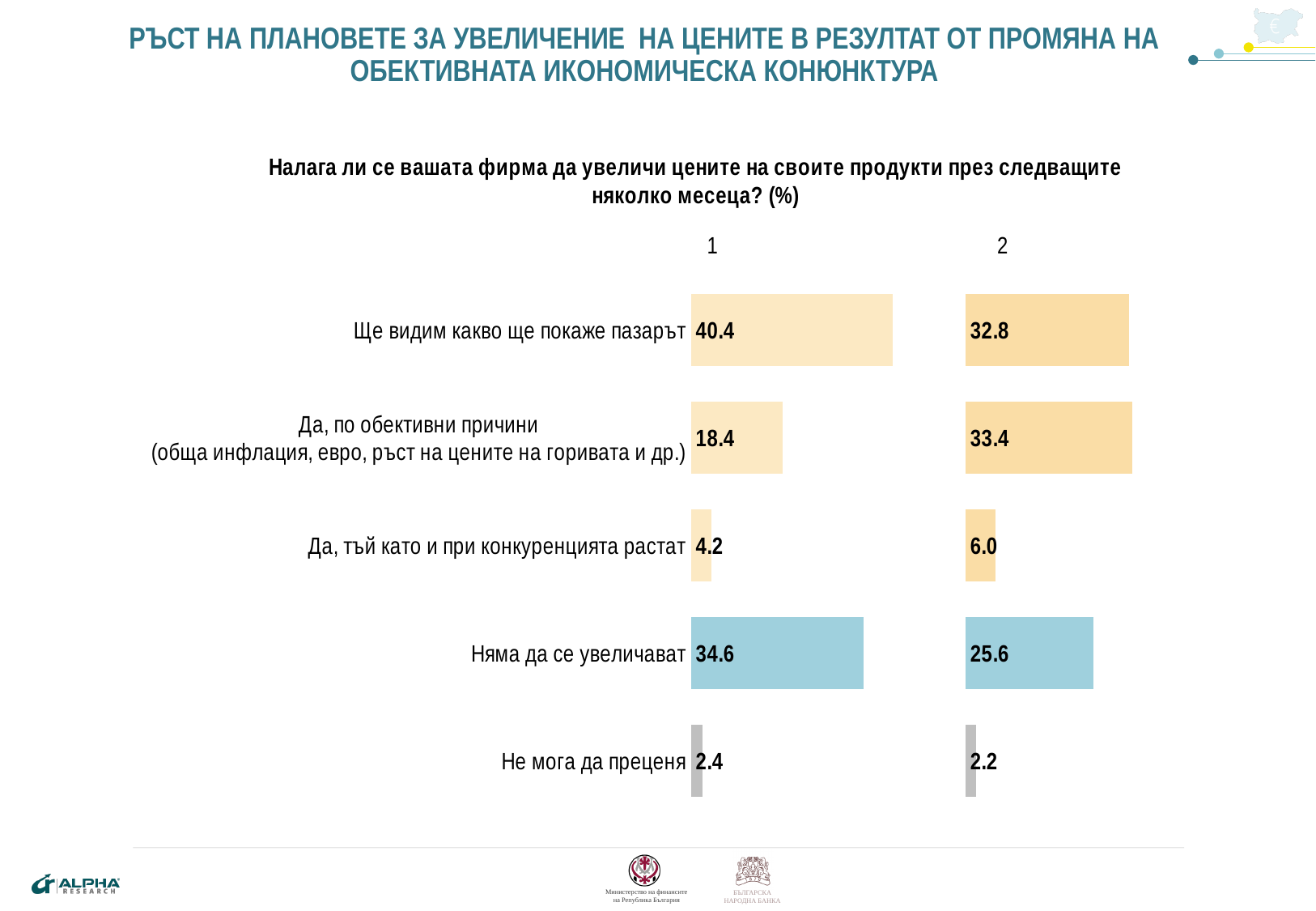
What is the value for "Ще видим какво ще покаже пазарът" in series 1? 40.4 What is the difference between series 1 and series 2 for "Ще видим какво ще покаже пазарът"? 7.6 Which is larger for "Да, тъй като и при конкуренцията растат": series 1 or series 2? series 2 What kind of chart is shown on the slide? bar chart What is the value for "Няма да се увеличават" in series 2? 25.6 What is the difference between series 1 and series 2 for "Да, по обективни причини"? 15.0 How many categories does the chart show? 5 What is the value for "Да, по обективни причини" in series 2? 33.4 Which category has the lowest value in series 2? Не мога да преценя How many series does the chart show? 2 What is the value for "Не мога да преценя" in series 1? 2.4 Which category has the highest value in series 1? Ще видим какво ще покаже пазарът